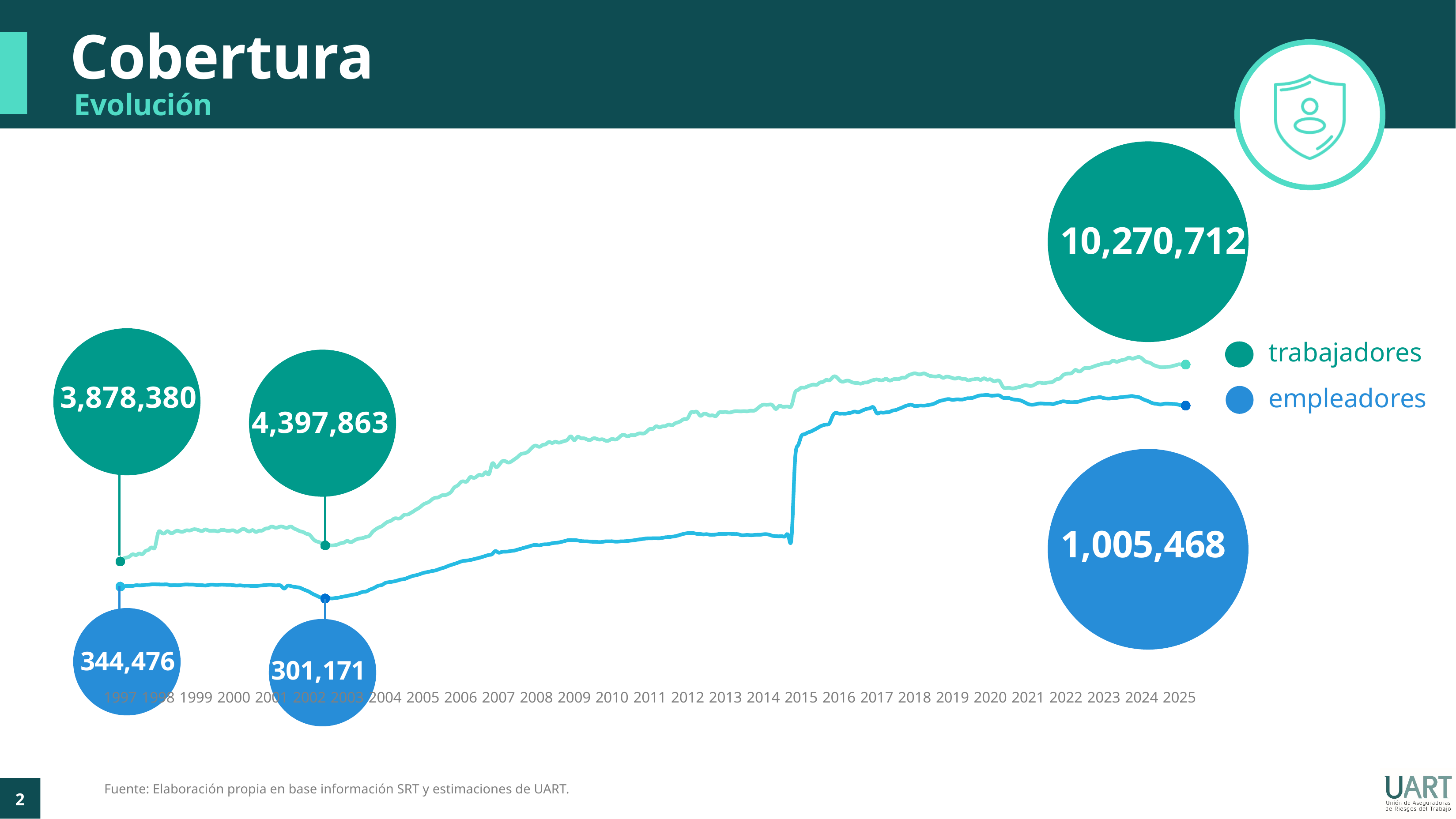
What value is shown in the second empleadores callout from the left (at the dip around 2002–2003)? 301,171 What is the value of empleadores shown for 1997? 344,476 How many series does the legend list? 2 What is the value of trabajadores shown for 2025? 10,270,712 By how much did the empleadores value increase from 1997 to 2025? 660,992 What kind of chart is shown on the slide? line chart By how much did the trabajadores value increase from 1997 to 2025? 6,392,332 Overall, does the trabajadores line rise or fall from 1997 to 2025? rise What is the value of trabajadores shown for 1997? 3,878,380 What is the value of empleadores shown for 2025? 1,005,468 What are the two series named in the legend? trabajadores and empleadores What value is shown in the second trabajadores callout from the left (at the dip around 2002–2003)? 4,397,863